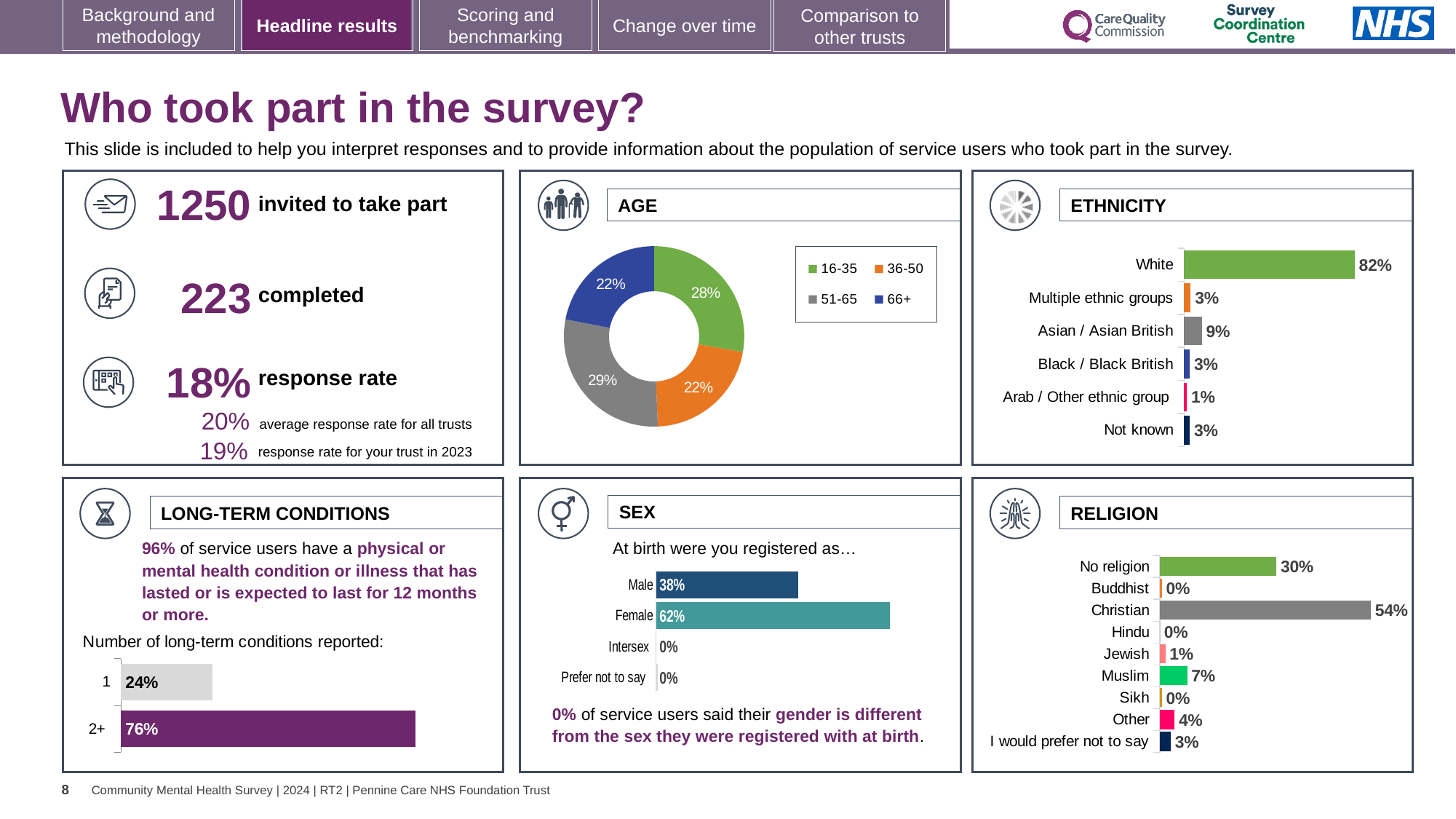
In the ETHNICITY chart, which category has the lowest value? Arab / Other ethnic group In the ETHNICITY chart, what is the value for Asian / Asian British? 9% In the ETHNICITY chart, what is the difference between White and Asian / Asian British? 73% In the AGE chart, what share of respondents were aged 51-65? 29% What kind of chart is the AGE chart? Doughnut (pie) chart In the RELIGION chart, what is the difference between Christian and No religion? 24% How many categories are shown in the ETHNICITY chart? 6 In the SEX chart, which is larger, Male or Female? Female In the RELIGION chart, what is the value for Muslim? 7% In the AGE chart, which age group has the largest share? 51-65 In the LONG-TERM CONDITIONS chart, what percentage of service users reported 2+ conditions? 76% How many entries does the legend of the AGE chart list? 4